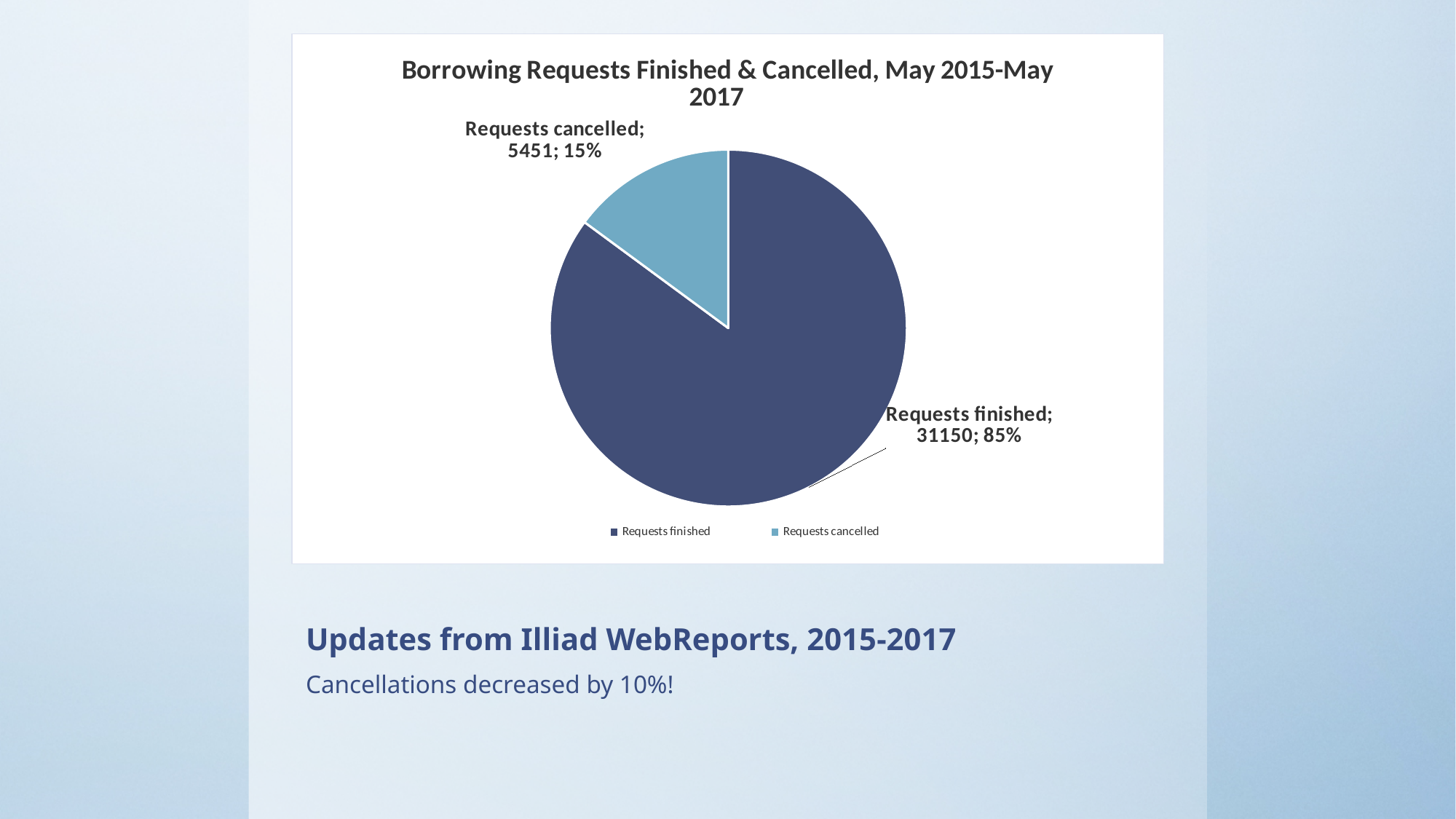
What is the total number of requests shown in the pie chart? 36601 Which category has the smallest slice of the pie? Requests cancelled How many requests were finished according to the chart? 31150 Which category has the largest slice of the pie? Requests finished Which is larger: requests finished or requests cancelled? Requests finished What is the difference between the number of requests finished and requests cancelled? 25699 What is the title of the chart? Borrowing Requests Finished & Cancelled, May 2015-May 2017 What share of the pie do cancelled requests represent? 15% What share of the pie do finished requests represent? 85% How many categories does the pie chart show? 2 What type of chart is shown on the slide? pie chart How many requests were cancelled according to the chart? 5451